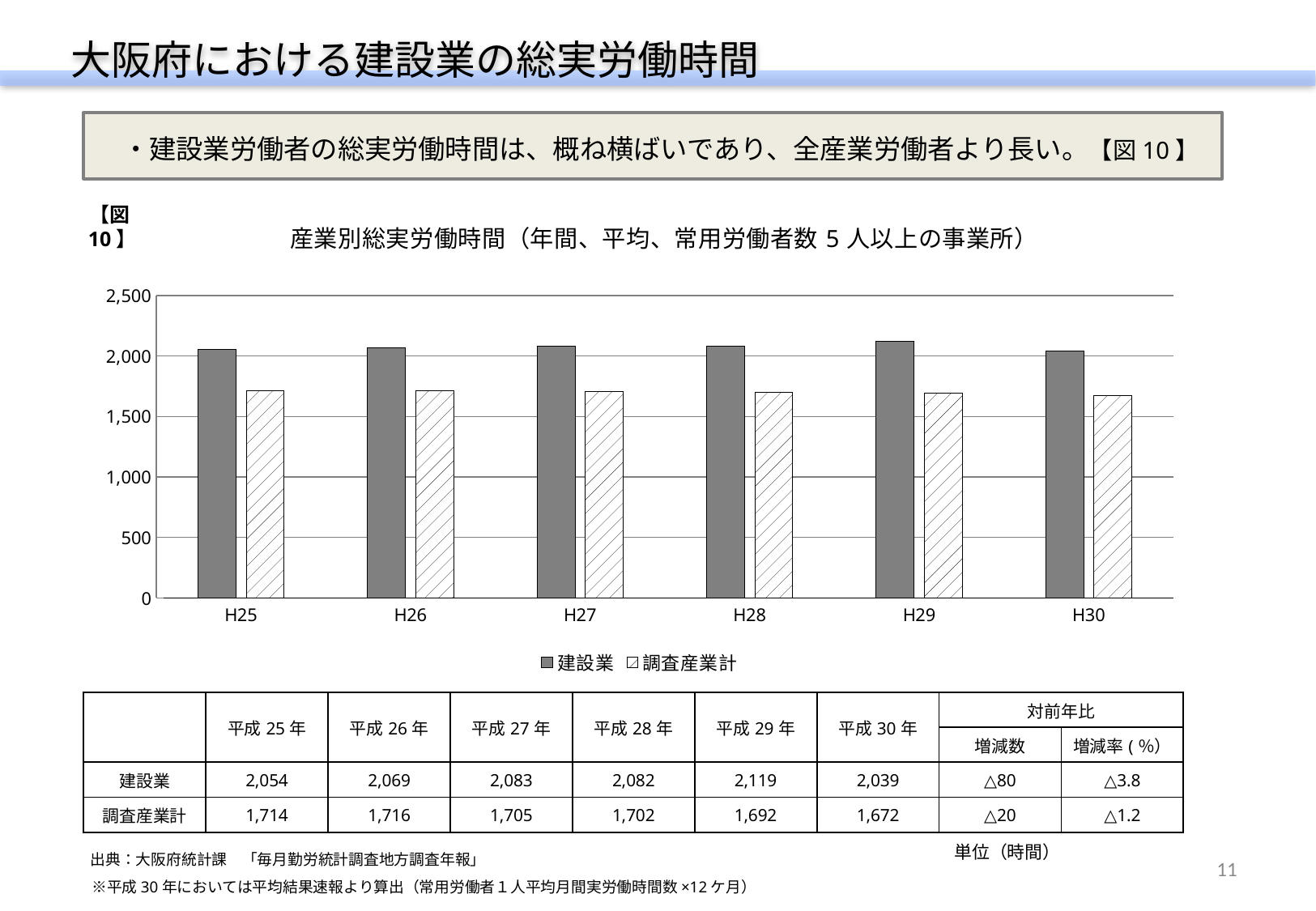
What is the value for 建設業 in H29? 2,119 Do the 調査産業計 values rise or fall from H26 to H30? fall Is the value for 調査産業計 in H26 greater or less than 2,000? less In which year is the 調査産業計 value lowest? H30 How many year categories are shown on the x axis of the chart? 6 What is the difference between 建設業 and 調査産業計 in H25? 340 Which series has the larger value in H27, 建設業 or 調査産業計? 建設業 What kind of chart is shown on the slide? bar chart What is the title of the chart? 産業別総実労働時間（年間、平均、常用労働者数5人以上の事業所） What is the value for 調査産業計 in H30? 1,672 How many series does the chart legend list? 2 In which year is the 建設業 value highest? H29